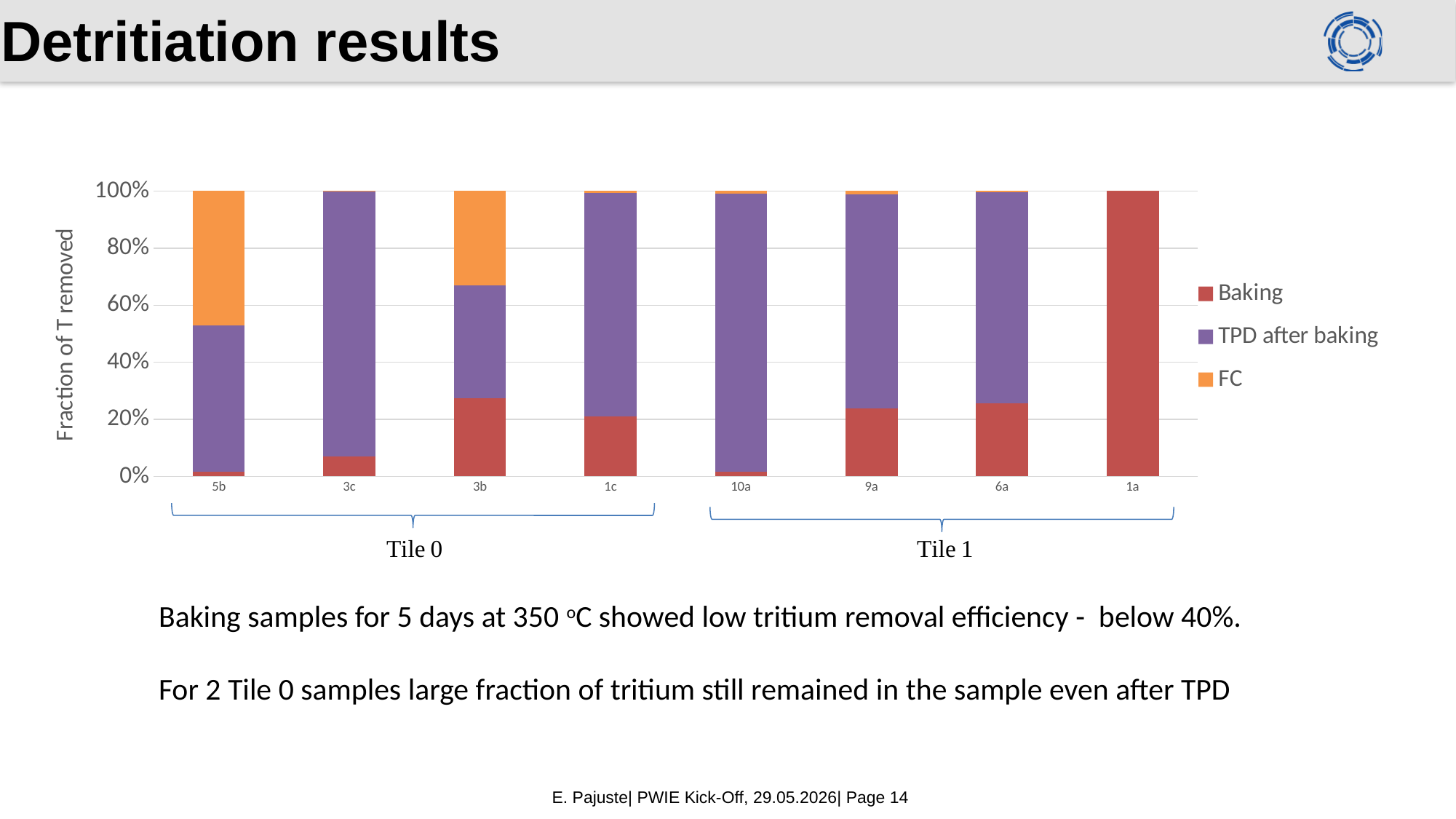
Which sample has the largest FC segment? 5b How many sample categories are plotted along the x axis? 8 What is the total height of the stacked bar for 1a? 100% Is the TPD after baking value for 3c greater or less than 80%? greater Is the Baking value for 3c greater or less than 20%? less Is the Baking value for 3b greater or less than 20%? greater What kind of chart is shown on the slide? Stacked bar chart Which sample has the highest Baking fraction? 1a Which has the larger Baking segment, 3b or 3c? 3b How many series does the legend list? 3 What is the title of the y axis? Fraction of T removed